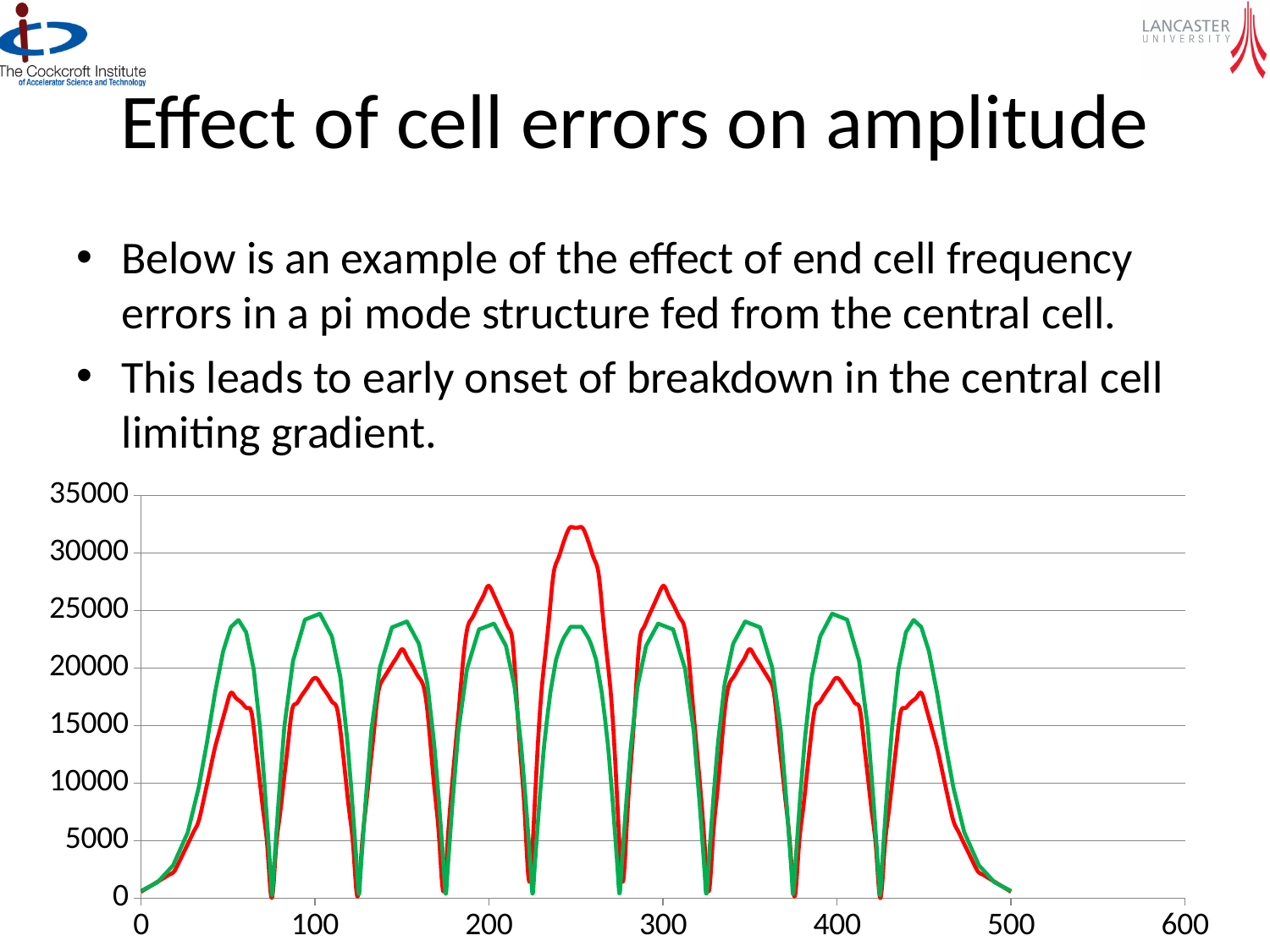
What colours are the two lines on the chart? red and green How many peaks does the red line have? 9 Is the peak of the green line near x = 100 greater or less than 20000? greater How many lines are plotted on the chart? 2 At x = 250, which line reaches the higher value, red or green? red Is the peak of the green line near x = 250 greater or less than 25000? less What kind of chart is shown on the slide? line chart At x = 50, which line reaches the higher value, red or green? green Is the highest peak of the red line (near x = 250) greater or less than 30000? greater What is the highest value labelled on the vertical axis? 35000 Which line has the highest peak on the chart, red or green? red